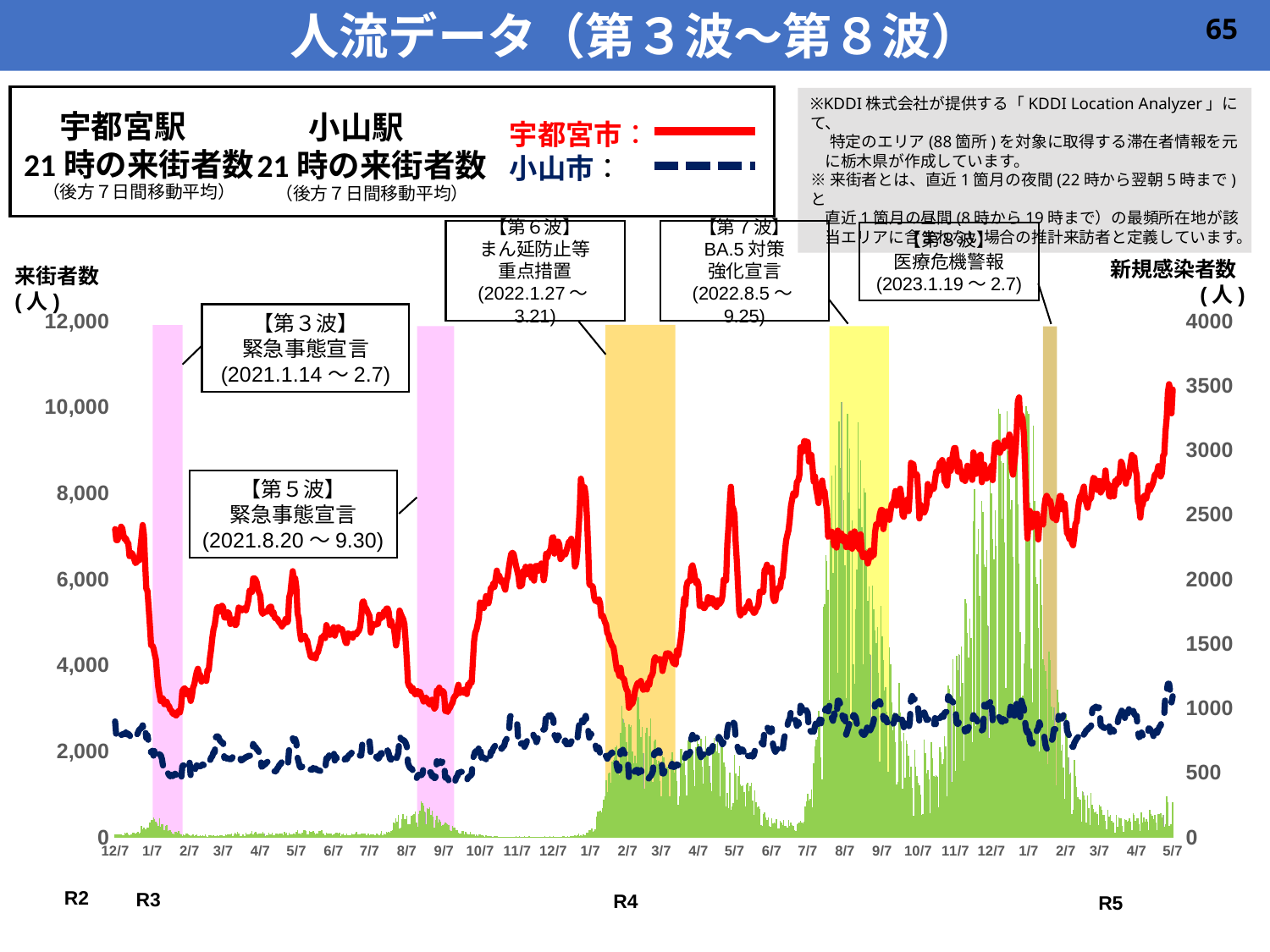
How many series does the legend list? 2 Which two series are listed in the legend? 宇都宮市 and 小山市 What kind of chart is shown on the slide? combination chart (lines and bars) Does the 宇都宮市 line rise or fall between 12/7 (R2) and 1/7 (R3)? fall Is the value for 宇都宮市 at the end of the chart (5/7, R5) greater or less than 10,000? greater Is the peak of 新規感染者数 (green bars) around 12/7 R4 greater or less than 3000 on the right axis? greater Which series has the higher 来街者数 throughout the chart, 宇都宮市 or 小山市? 宇都宮市 What colour and style is the line for 小山市? navy dashed line What is the maximum value shown on the left axis (来街者数)? 12,000 Is the value for 小山市 at the start of the chart (12/7, R2) greater or less than 2,000? greater